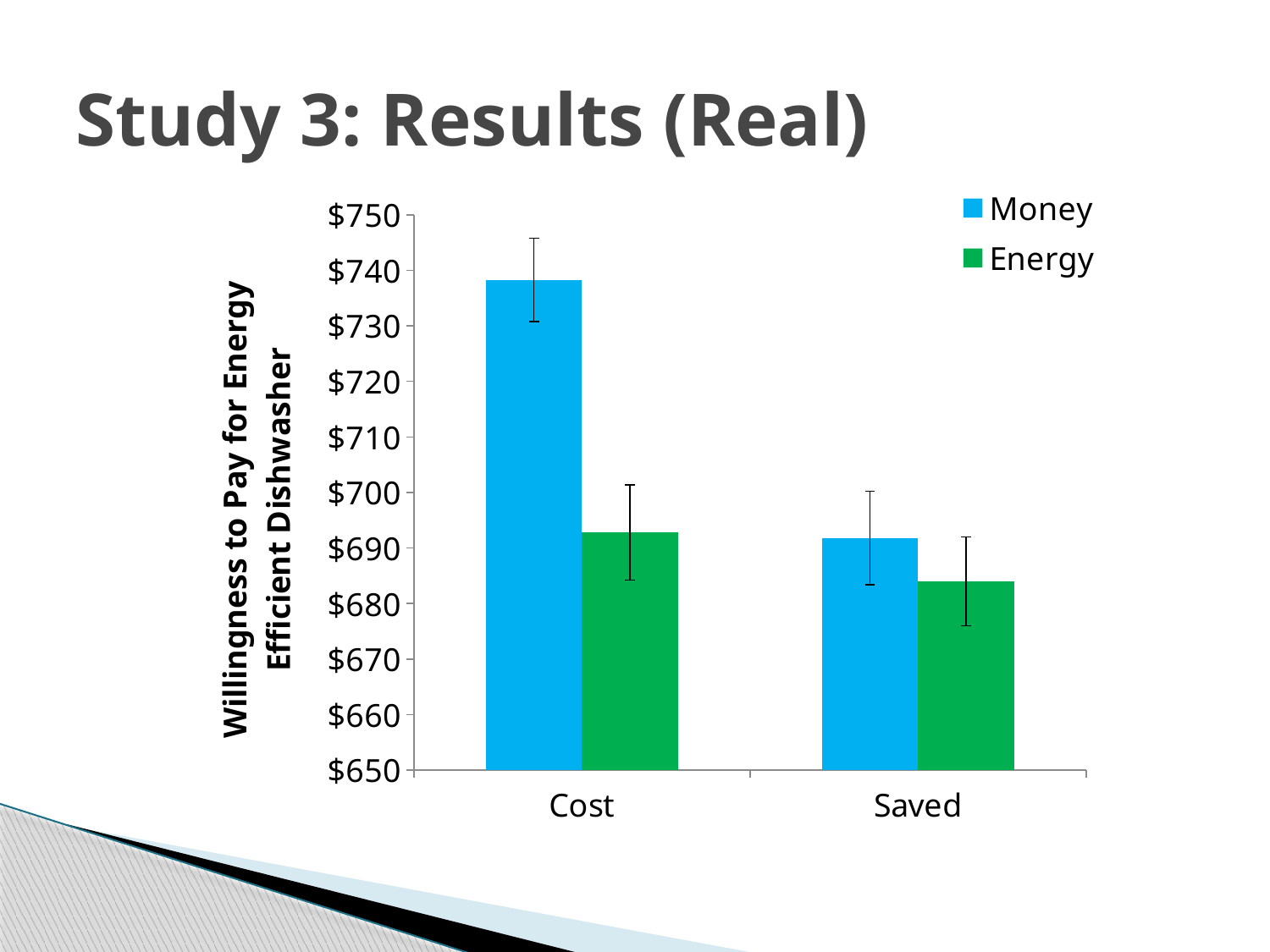
How many categories are shown on the x axis? 2 Which bar is the highest in the chart? Money for Cost What kind of chart is shown on the slide? bar chart Is the Money value for Saved greater or less than $700? less Is the Energy value for Saved greater or less than $690? less What is the title of the vertical axis? Willingness to Pay for Energy Efficient Dishwasher Which bar is the lowest in the chart? Energy for Saved Does the Money series rise or fall from Cost to Saved? fall Is the Money value for Cost greater or less than $730? greater How many series does the legend list? 2 For the Cost category, which is larger: Money or Energy? Money